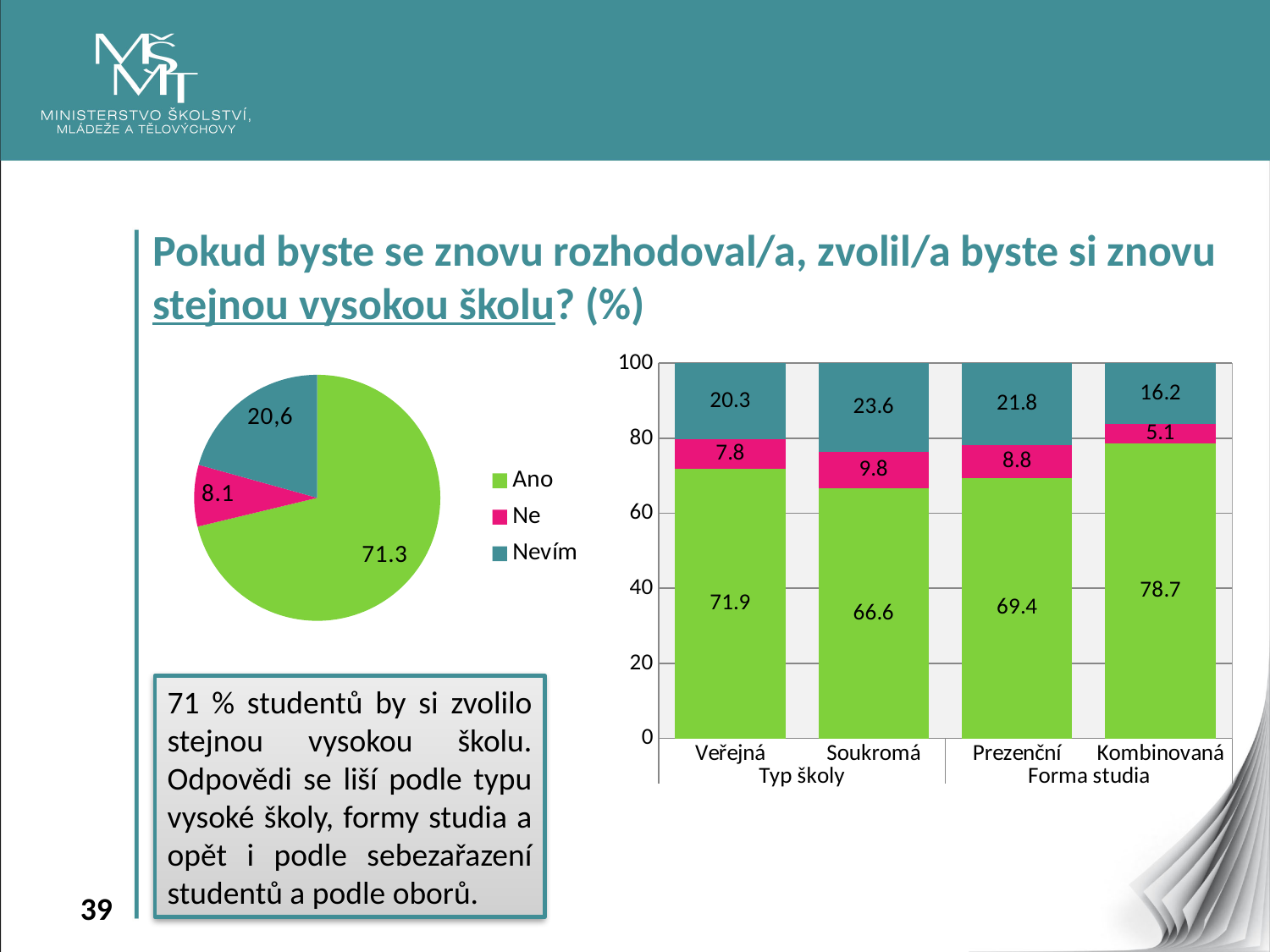
What kind of chart is the chart on the right of the slide? Stacked bar chart In the bar chart on the right, what is the value of the bottom (green) segment for "Kombinovaná"? 78.7 In the pie chart on the left, what value is shown for the "Nevím" slice? 20,6 In the pie chart on the left, how many entries does the legend list? 3 In the bar chart on the right, what is the difference between the bottom (green) segment values of "Kombinovaná" and "Soukromá"? 12.1 In the pie chart on the left, which slice is the smallest? Ne In the bar chart on the right, is the middle (pink) segment larger for "Soukromá" or for "Kombinovaná"? Soukromá In the bar chart on the right, which category has the lowest value in its bottom (green) segment? Soukromá In the bar chart on the right, how many categories are shown on the x axis? 4 In the bar chart on the right, what is the value of the top (teal) segment for "Soukromá"? 23.6 In the pie chart on the left, what is the difference between the "Ano" value and the "Ne" value? 63.2 In the pie chart on the left, what value is shown for the "Ano" slice? 71.3